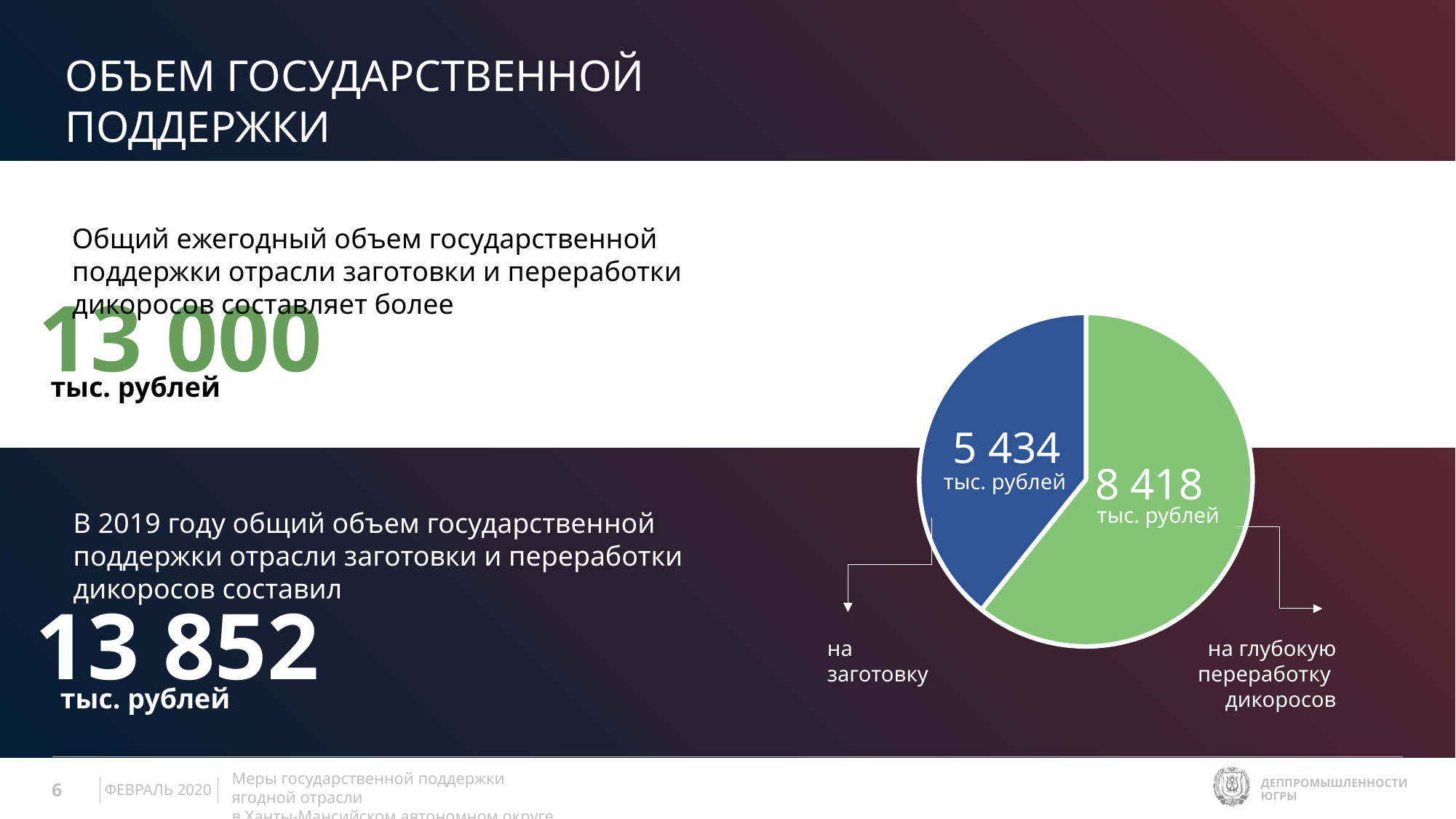
Which slice of the pie chart is the largest? на глубокую переработку дикоросов Which slice of the pie chart is the smallest? на заготовку What is the value of the slice labelled «на заготовку»? 5 434 тыс. рублей What colour is the slice for «на заготовку»? Blue Which is larger: the amount for «на заготовку» or for «на глубокую переработку дикоросов»? на глубокую переработку дикоросов What is the total of the two slices of the pie chart, in тыс. рублей? 13 852 How many slices does the pie chart have? 2 What is the difference between the two slices of the pie chart, in тыс. рублей? 2 984 What kind of chart is shown on the slide? Pie chart What is the value of the slice labelled «на глубокую переработку дикоросов»? 8 418 тыс. рублей What colour is the slice for «на глубокую переработку дикоросов»? Green